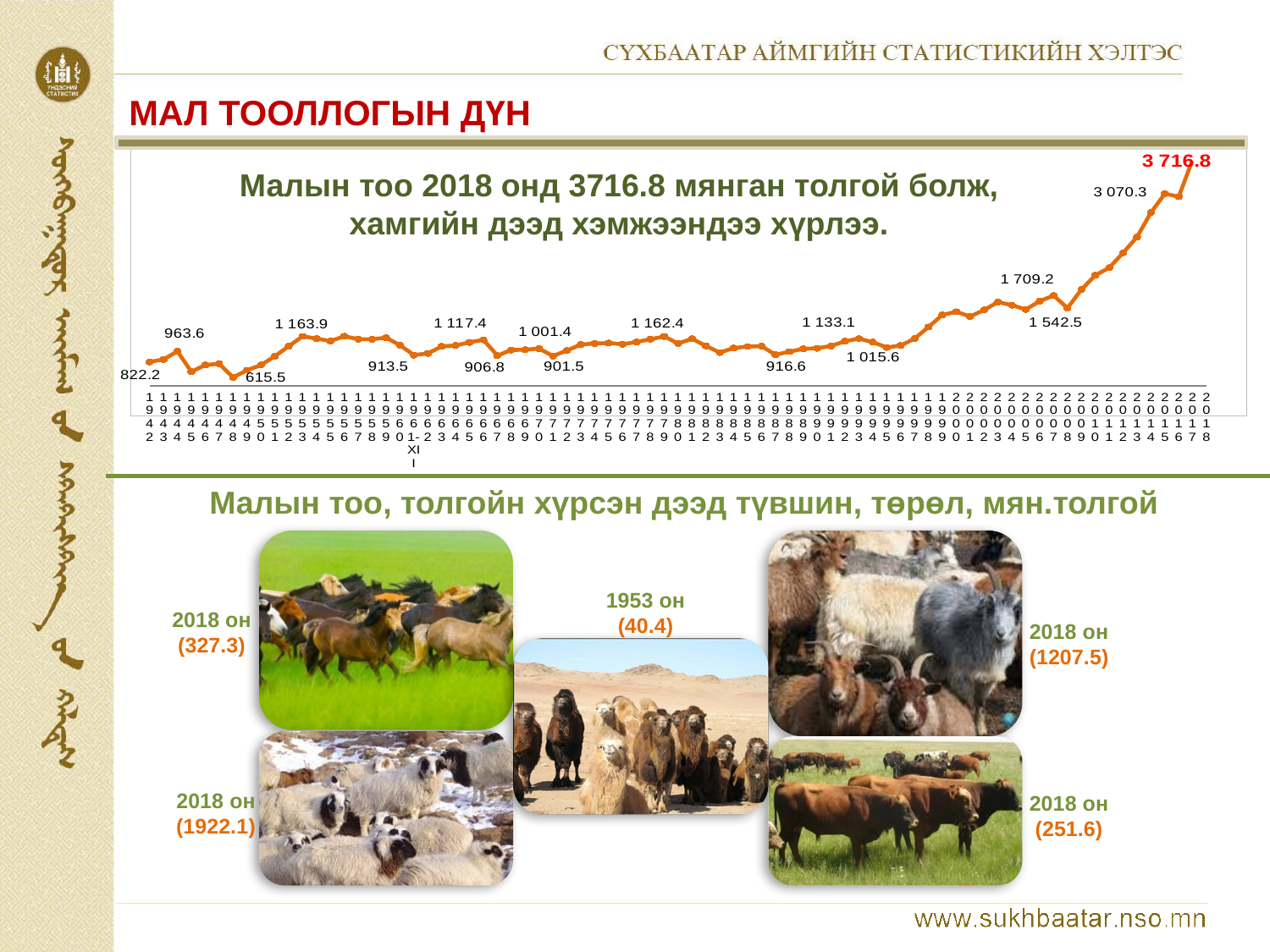
What is the lowest value labelled on the line chart? 615.5 What colour is the line plotted on the chart? orange Which labelled value is larger on the line chart: 1 709.2 or 1 542.5? 1 709.2 Which labelled value is larger on the line chart: 1 015.6 or 916.6? 1 015.6 What is the livestock count shown for 2018 on the line chart? 3 716.8 What is the difference between the labelled values 1 709.2 and 1 542.5 on the line chart? 166.7 What kind of chart is shown on the slide? line chart What is the difference between the labelled values 3 716.8 and 3 070.3 on the line chart? 646.5 What is the highest value labelled on the line chart? 3 716.8 What is the difference between the labelled values 963.6 and 615.5 on the line chart? 348.1 What is the value labelled at the first point (1942) of the line chart? 822.2 Overall, does the line on the chart rise or fall from 1942 to 2018? rise